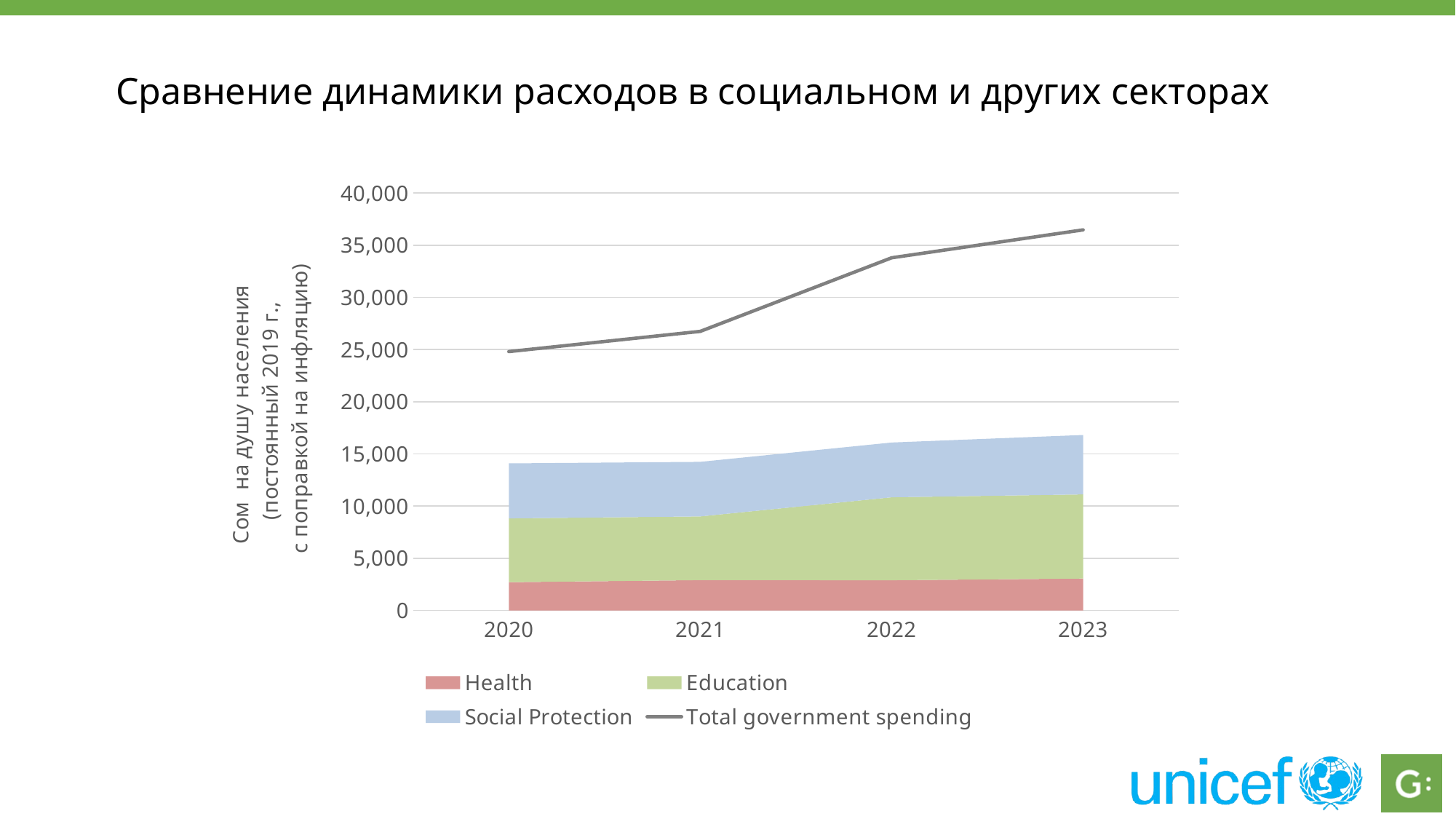
Is the value for Total government spending in 2023 greater or less than 35,000? greater How many series does the legend list? 4 What kind of chart is shown on the slide? A stacked area chart with a line series Is the combined top of the stacked areas (Health, Education and Social Protection) in 2023 greater or less than 15,000? greater Which series is shown as a line rather than a shaded area? Total government spending Is the combined top of the stacked areas (Health, Education and Social Protection) in 2020 greater or less than 15,000? less How many years are shown on the x axis? 4 Which year has the highest value for Total government spending? 2023 Which year has the lowest value for Total government spending? 2020 Does Total government spending rise or fall from 2020 to 2023? Rises